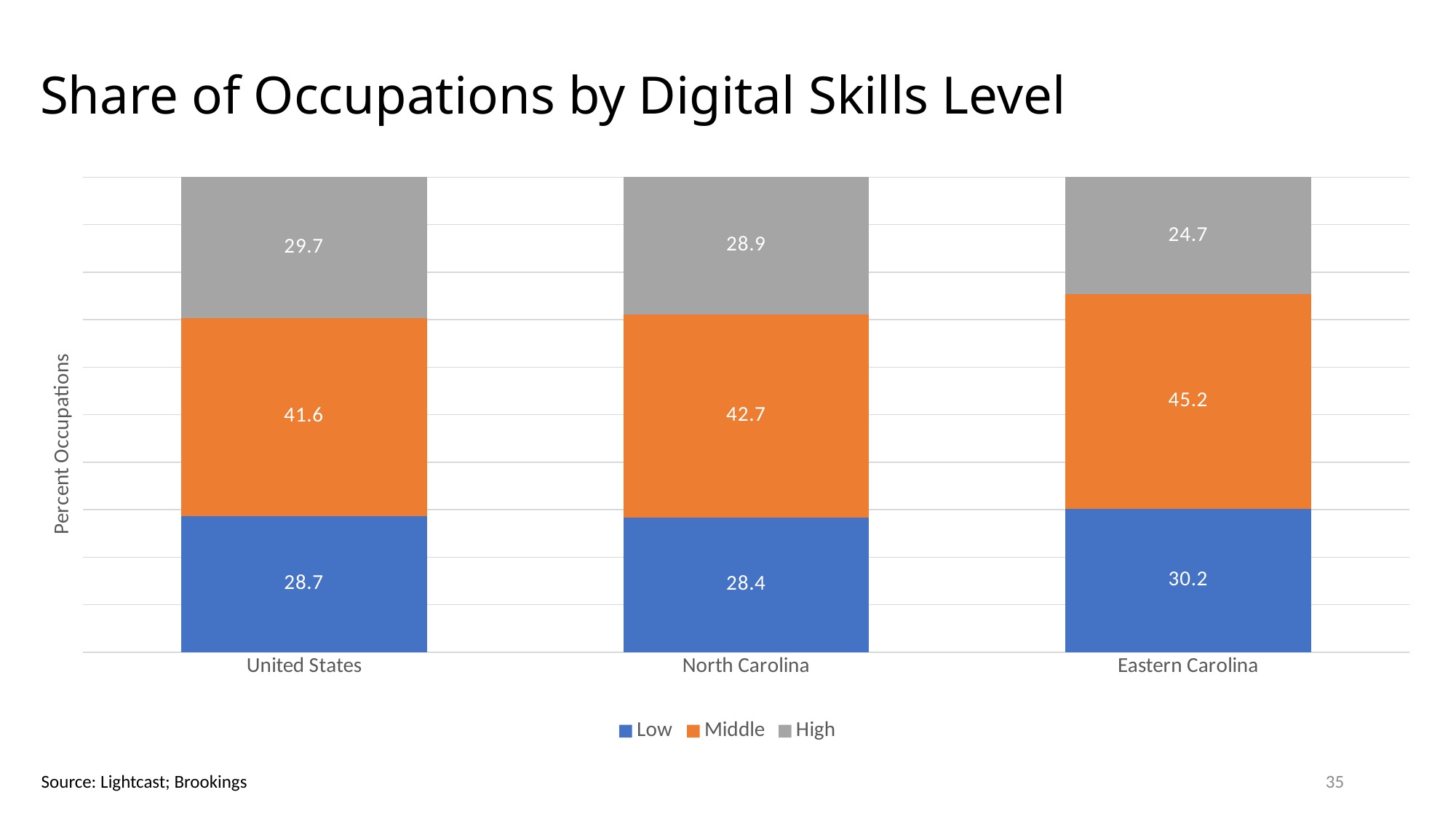
How many categories are shown on the x axis? 3 What is the title of the chart? Share of Occupations by Digital Skills Level What is the difference between the Middle values for Eastern Carolina and United States? 3.6 What is the High value for United States? 29.7 Which category has the lowest High value? Eastern Carolina Which is larger, the Low value for Eastern Carolina or the Low value for United States? Eastern Carolina What is the Low value for North Carolina? 28.4 What is the Middle value for Eastern Carolina? 45.2 What is the total of the stacked bar for North Carolina? 100.0 Which category has the highest Middle value? Eastern Carolina What kind of chart is shown? Stacked bar chart How many series does the legend list? 3